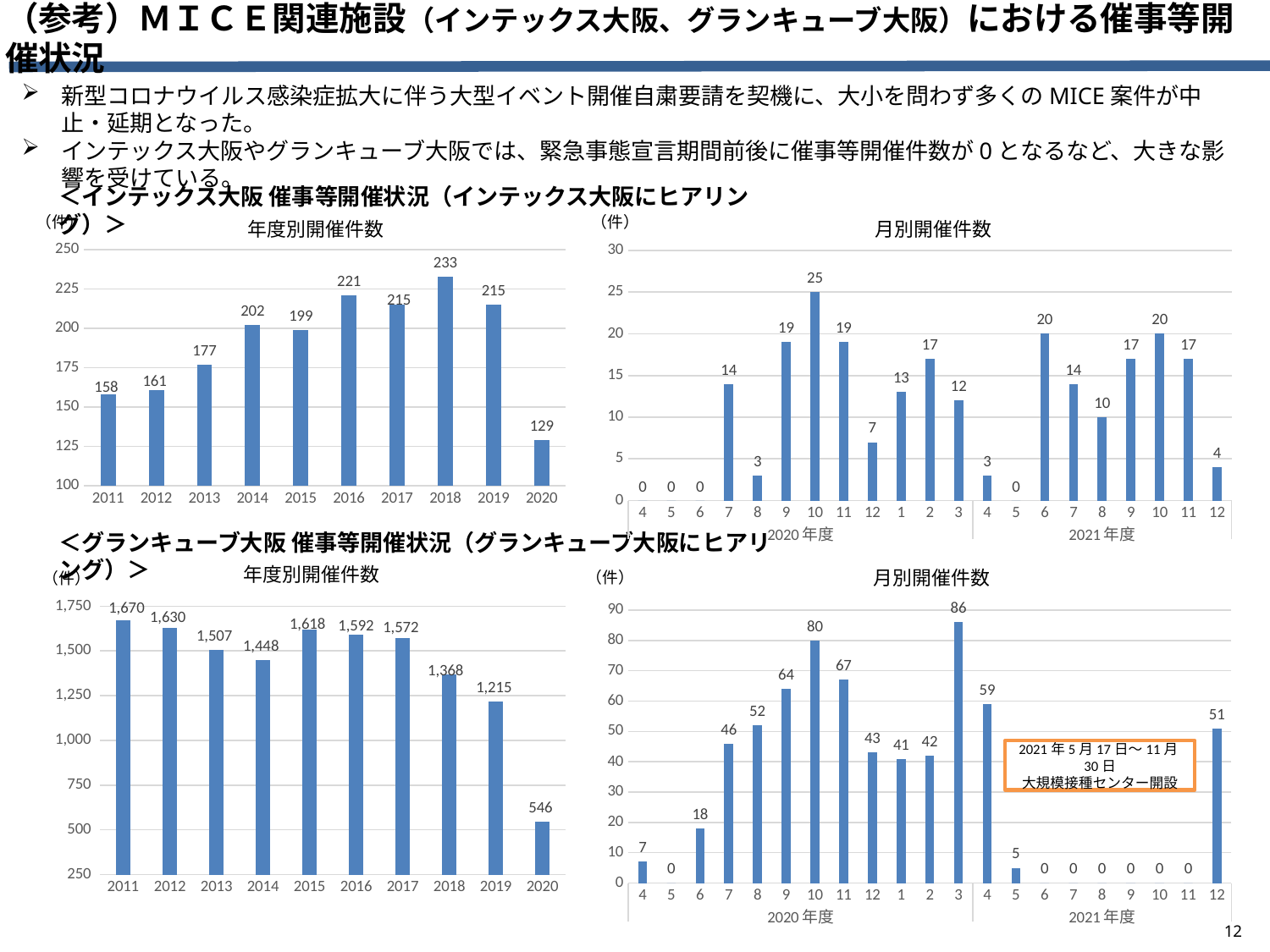
What type of chart is the bottom-left chart (グランキューブ大阪 年度別開催件数)? Bar chart In the bottom-left chart (グランキューブ大阪 年度別開催件数), what is the difference between the 2019 and 2020 values? 669 In the top-right chart (インテックス大阪 月別開催件数), which is larger: month 7 of 2020年度 or month 7 of 2021年度? They are equal (14) In the top-right chart (インテックス大阪 月別開催件数), what is the value for month 12 of 2021年度? 4 In the bottom-right chart (グランキューブ大阪 月別開催件数), what is the value for month 4 of 2021年度? 59 In the top-left chart (インテックス大阪 年度別開催件数), what is the difference between the 2019 and 2020 values? 86 In the top-right chart (インテックス大阪 月別開催件数), what is the value for month 10 of 2020年度? 25 In the bottom-left chart (グランキューブ大阪 年度別開催件数), what is the value for 2011? 1,670 In the bottom-right chart (グランキューブ大阪 月別開催件数), which month has the highest value? Month 3 of 2020年度 (86) In the top-left chart (インテックス大阪 年度別開催件数), which year has the lowest value? 2020 In the top-left chart (インテックス大阪 年度別開催件数), what is the value for 2018? 233 In the top-left chart (インテックス大阪 年度別開催件数), how many years are plotted? 10